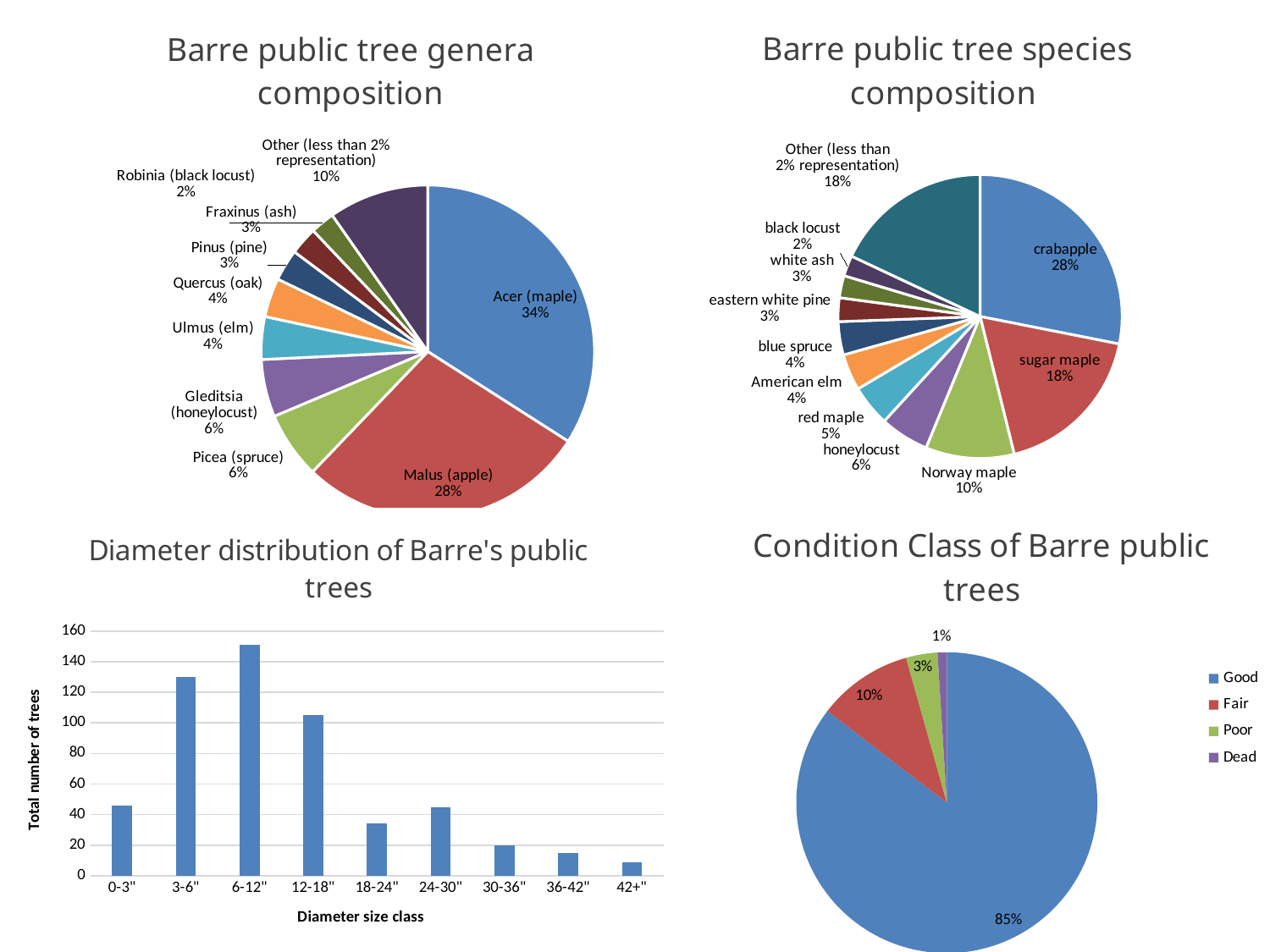
How many series does the legend of the 'Condition Class of Barre public trees' chart list? 4 In the 'Barre public tree genera composition' chart, which genus has the largest share? Acer (maple) In the 'Diameter distribution of Barre's public trees' chart, how many diameter size classes are shown? 9 What kind of chart is 'Diameter distribution of Barre's public trees'? bar chart In the 'Barre public tree genera composition' chart, what is the difference in percentage points between Acer (maple) and Malus (apple)? 6 In the 'Barre public tree species composition' chart, which is larger, Norway maple or honeylocust? Norway maple In the 'Barre public tree species composition' chart, which named species has the smallest share? black locust In the 'Condition Class of Barre public trees' chart, what percentage of trees are in Fair condition? 10% In the 'Barre public tree species composition' chart, what percentage is sugar maple? 18% In the 'Diameter distribution of Barre's public trees' chart, which diameter size class has the highest number of trees? 6-12" In the 'Barre public tree genera composition' chart, what percentage is Acer (maple)? 34% In the 'Diameter distribution of Barre's public trees' chart, is the value for 3-6" greater or less than 120? greater